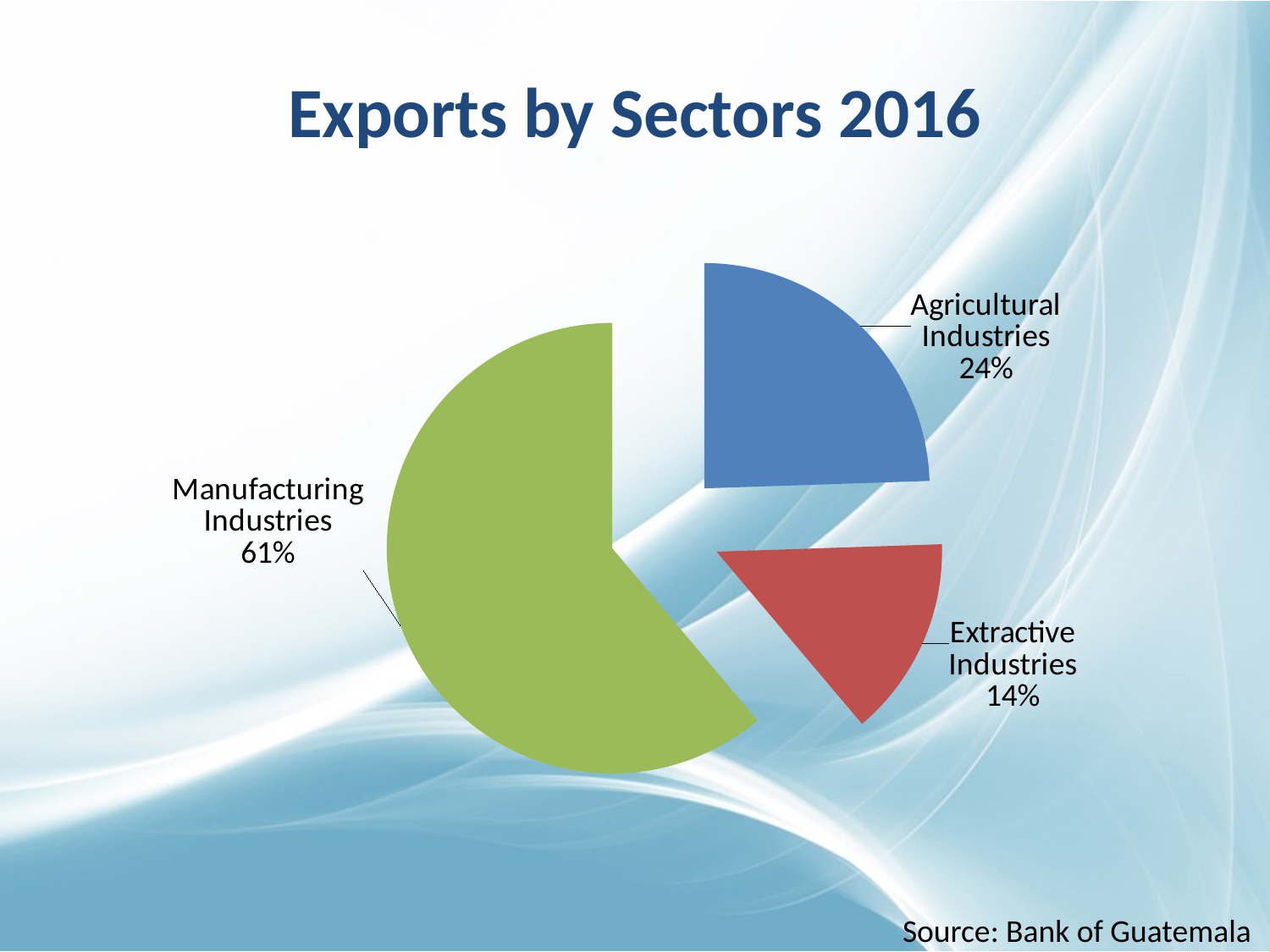
Which has a larger share of exports, Agricultural Industries or Extractive Industries? Agricultural Industries What share of exports do Manufacturing Industries account for? 61% Which sector has the largest share of exports? Manufacturing Industries What kind of chart is shown on the slide? pie chart What is the difference in percentage points between Manufacturing Industries and Agricultural Industries? 37 What is the difference in percentage points between Agricultural Industries and Extractive Industries? 10 What share of exports do Agricultural Industries account for? 24% What is the title of the chart? Exports by Sectors 2016 How many sectors are shown in the pie chart? 3 Which sector has the smallest share of exports? Extractive Industries What colour is the Manufacturing Industries slice? green What share of exports do Extractive Industries account for? 14%